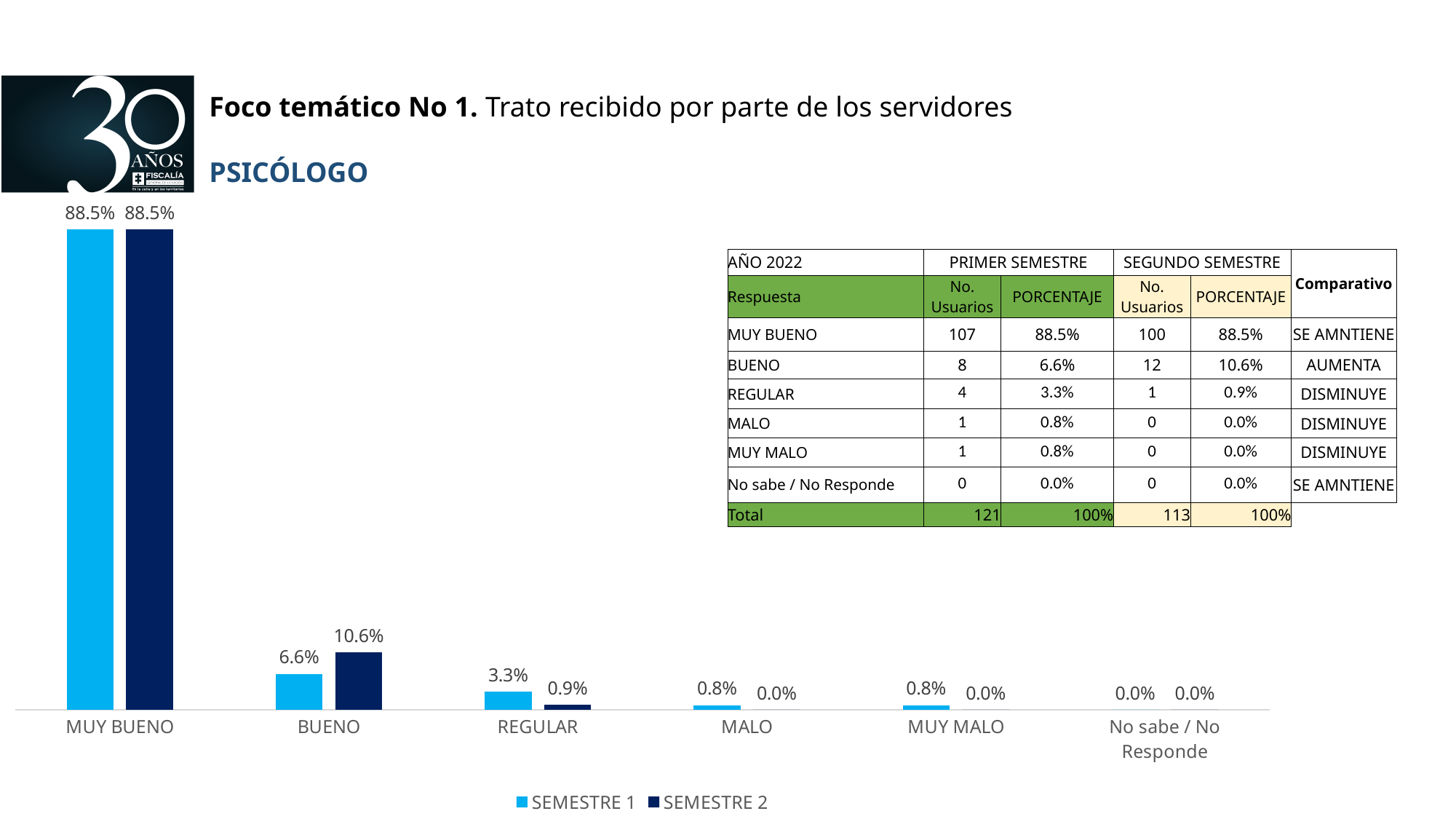
Which is larger for REGULAR, the SEMESTRE 1 value or the SEMESTRE 2 value? SEMESTRE 1 How many categories are shown on the x axis of the chart? 6 Which category has the highest SEMESTRE 2 value? MUY BUENO What is the SEMESTRE 2 value for REGULAR? 0.9% What are the two series named in the chart legend? SEMESTRE 1 and SEMESTRE 2 What is the difference between the SEMESTRE 2 and SEMESTRE 1 values for BUENO? 4.0% How many series does the chart legend list? 2 What is the difference between the SEMESTRE 1 values for BUENO and REGULAR? 3.3% What is the SEMESTRE 1 value for BUENO? 6.6% What kind of chart is shown on the slide? Bar chart What is the SEMESTRE 2 value for MUY BUENO? 88.5% What is the SEMESTRE 1 value for MUY MALO? 0.8%